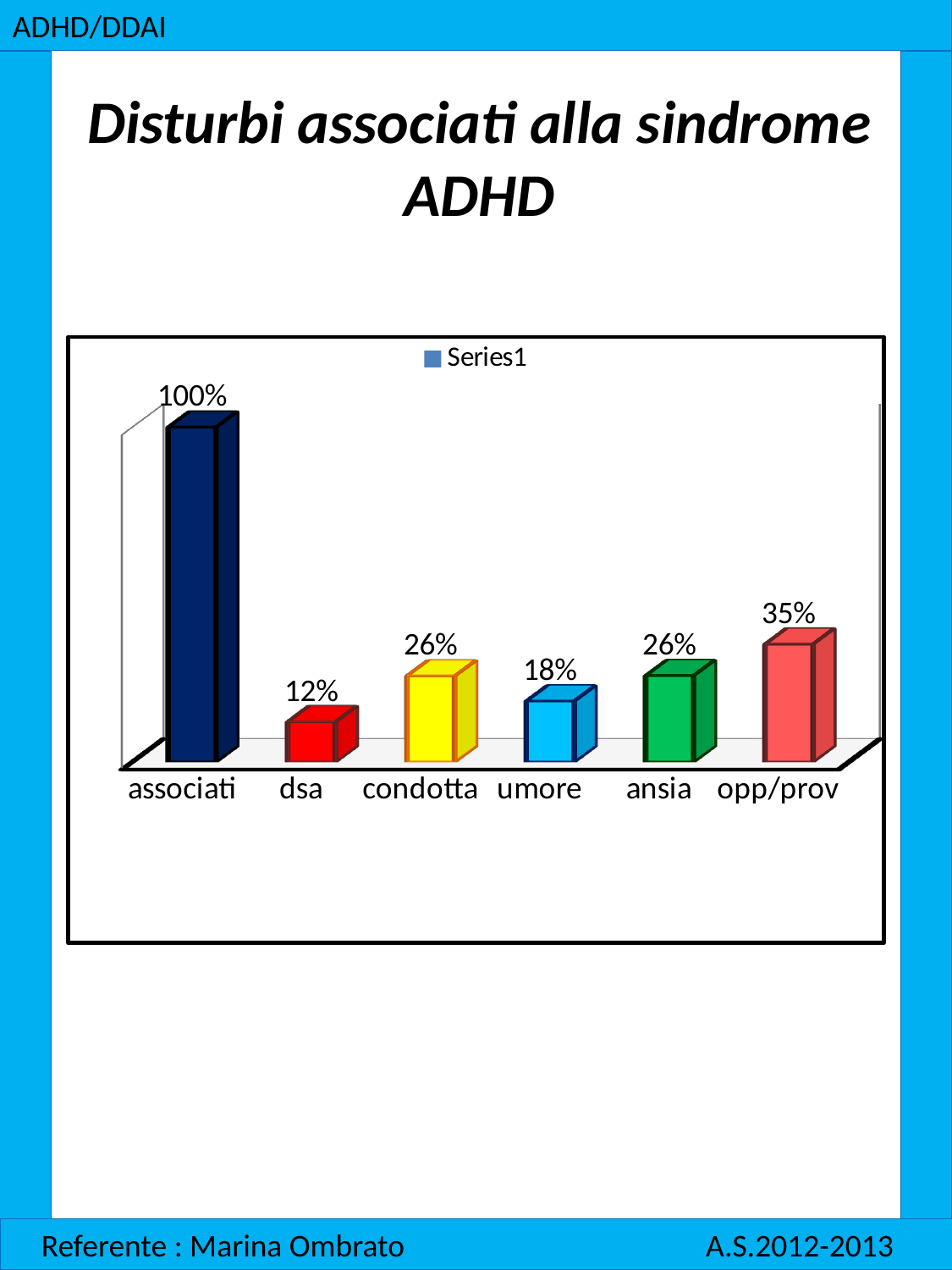
What is the value for dsa? 12% Which category has the highest value? associati Which category has the lowest value? dsa What is the value for opp/prov? 35% What kind of chart is shown? bar chart What is the difference between the values for opp/prov and umore? 17% How many series does the legend list? 1 What is the name of the series shown in the legend? Series1 What is the value for associati? 100% Which is larger, the value for condotta or the value for dsa? condotta What is the value for umore? 18% How many categories are shown on the x axis? 6